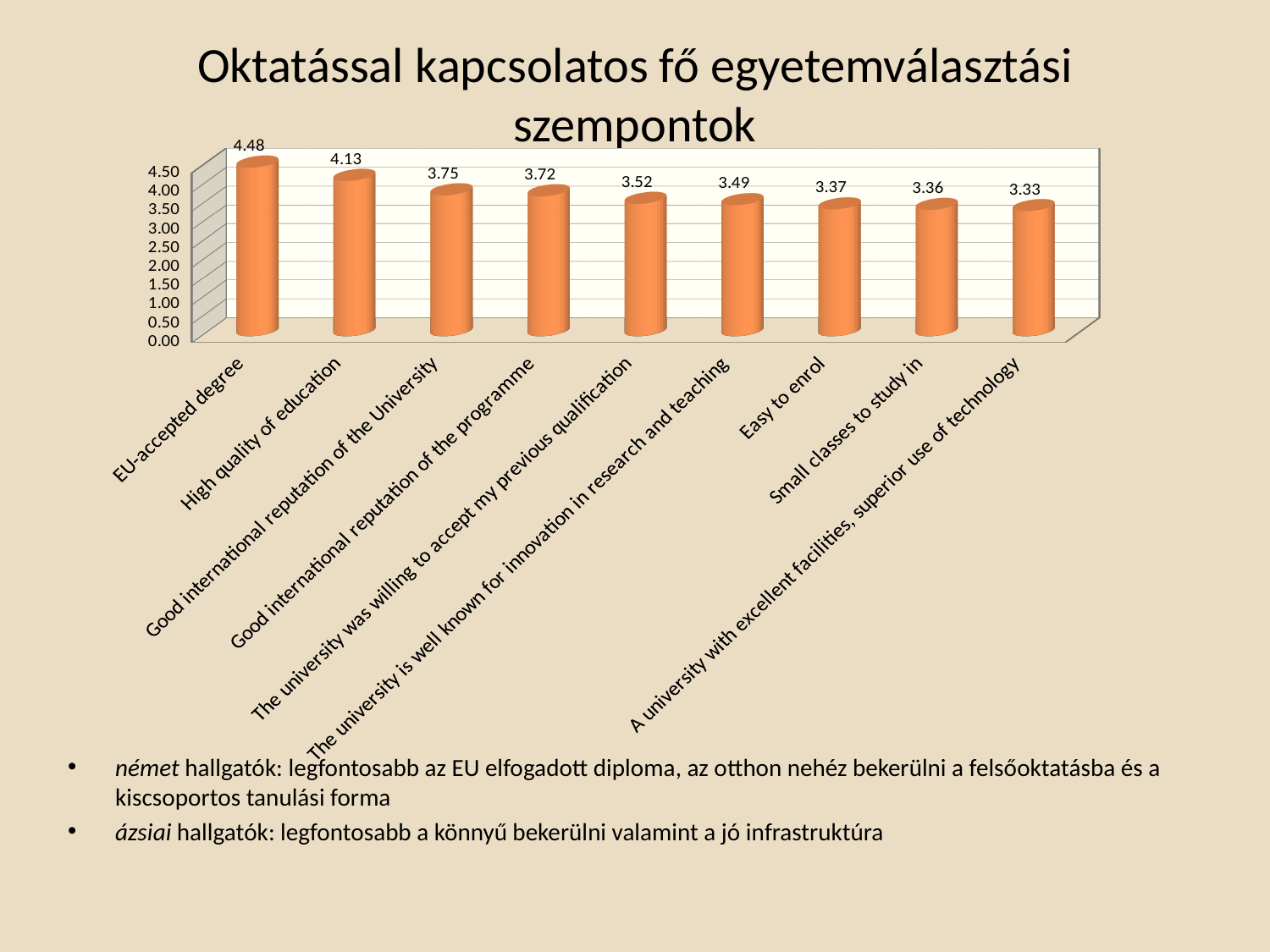
What is the difference between the values for EU-accepted degree and High quality of education? 0.35 What is the value for Small classes to study in? 3.36 Which category has the lowest value? A university with excellent facilities, superior use of technology How many categories are shown in the chart? 9 Which is larger: the value for Good international reputation of the University or the value for Easy to enrol? Good international reputation of the University What is the value for Easy to enrol? 3.37 What is the value for High quality of education? 4.13 Is the value for Good international reputation of the programme greater or less than 3.50? greater Which category has the highest value? EU-accepted degree Do the values rise or fall from left to right along the x axis? Fall What is the value for EU-accepted degree? 4.48 What kind of chart is shown on the slide? Bar chart